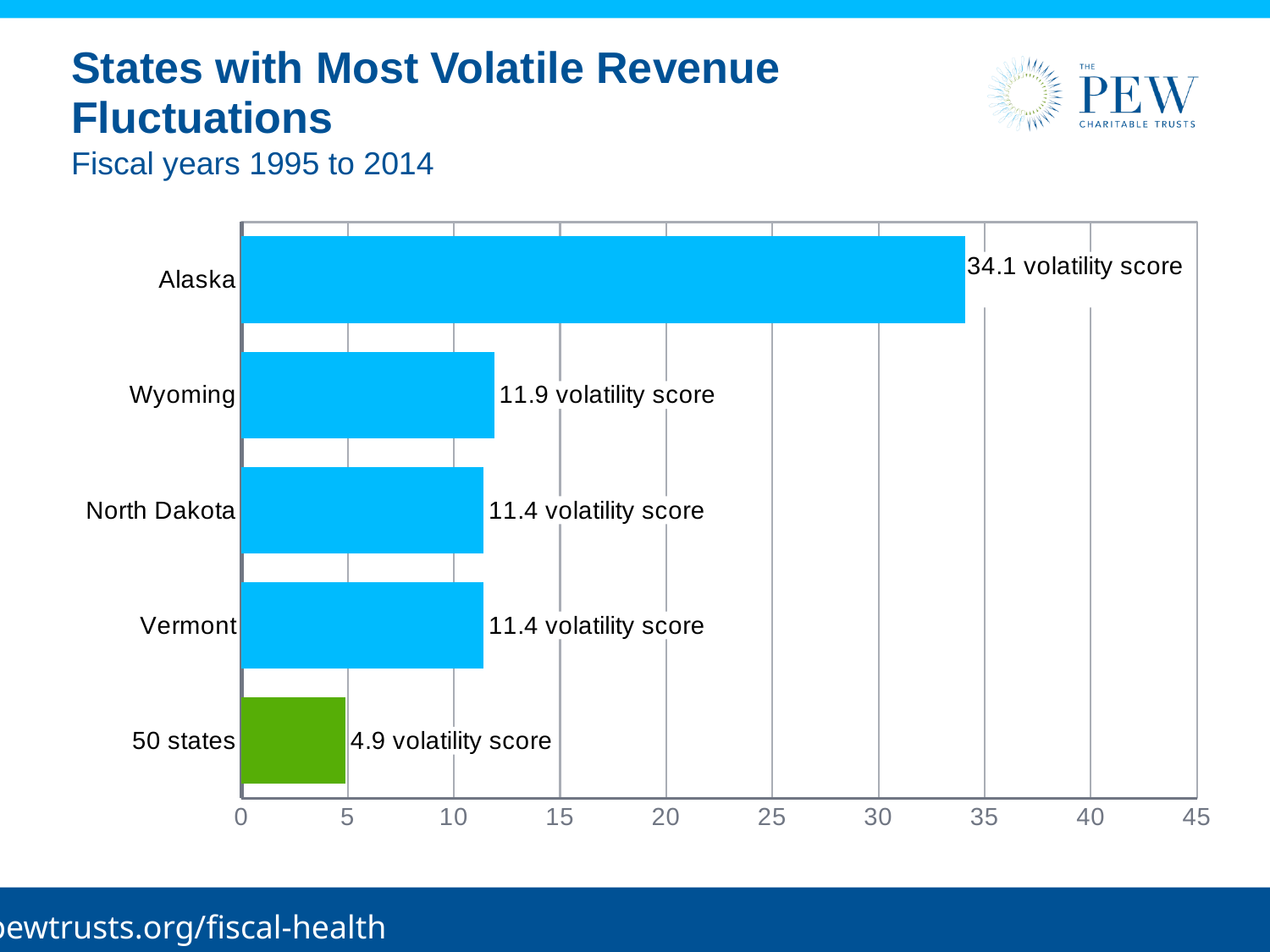
What is the volatility score for the 50 states bar? 4.9 Which category has the highest volatility score? Alaska Which category has the lowest volatility score? 50 states How many bars are shown in the chart? 5 Is the value for Alaska greater or less than 30? greater What is the volatility score for Wyoming? 11.9 What kind of chart is shown on the slide? Bar chart What is the difference between Alaska's and Wyoming's volatility scores? 22.2 What is the volatility score for Alaska? 34.1 Which bar is shown in a different colour (green) from the others? 50 states What is the difference between Vermont's volatility score and the 50 states volatility score? 6.5 Which has a larger volatility score, Wyoming or North Dakota? Wyoming